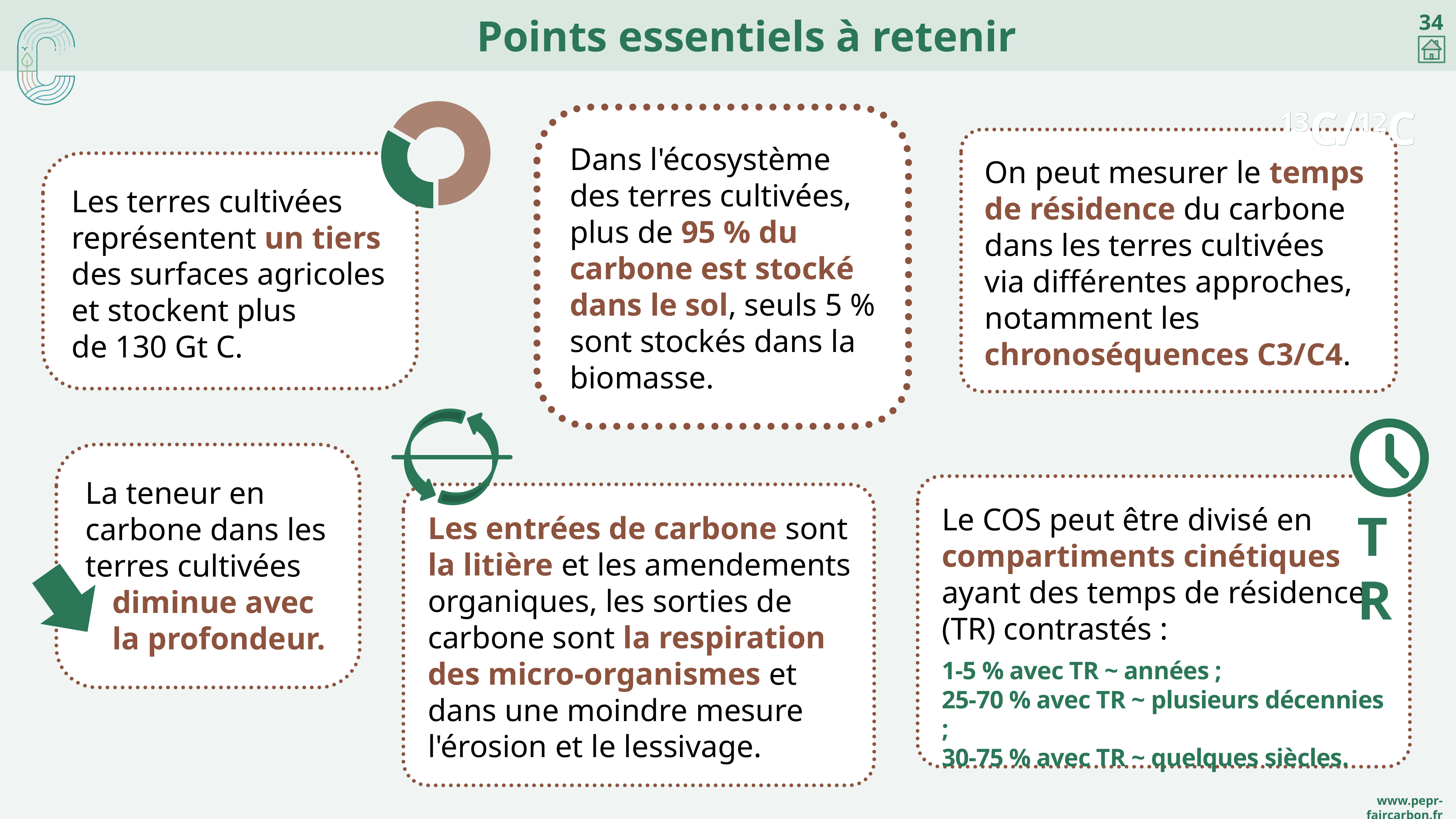
What kind of chart is the small graphic attached to the top-left text box? donut chart How many slices does the small donut chart at the top left have? 2 According to the adjacent text, what share of agricultural surfaces does the green slice of the top-left donut chart represent? un tiers In the small donut chart at the top left, which slice is larger, the green one or the brown one? the brown one What two colours are used for the slices of the small donut chart at the top left? green and brown